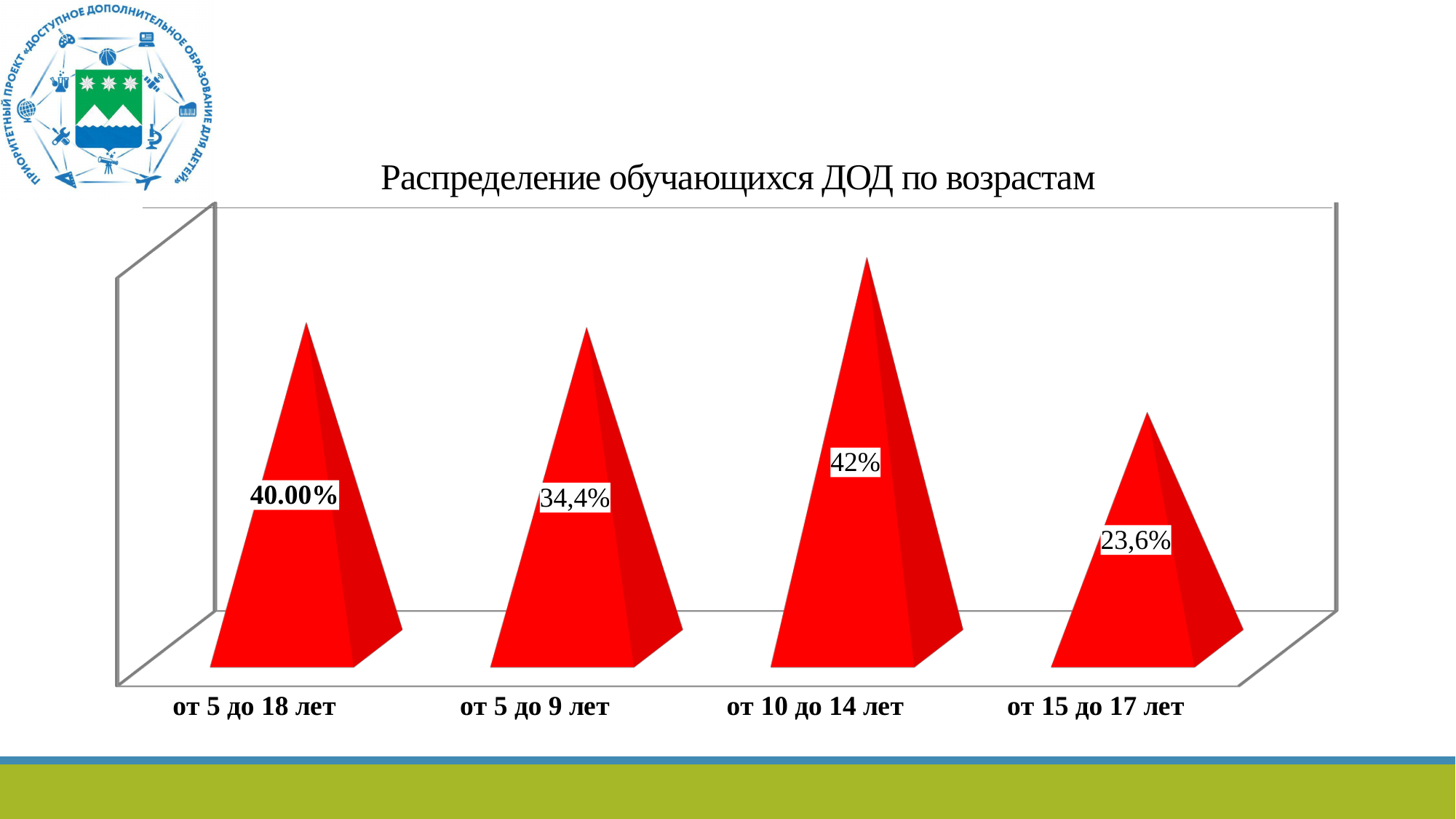
What is the value for the category "от 10 до 14 лет"? 42% What is the difference between the values for "от 10 до 14 лет" and "от 5 до 9 лет"? 7,6% What is the value for the category "от 5 до 18 лет"? 40.00% How many categories are shown on the chart? 4 Which category has the highest value? от 10 до 14 лет What kind of chart is shown on the slide? Bar chart What is the difference between the values for "от 5 до 9 лет" and "от 15 до 17 лет"? 10,8% What is the value for the category "от 5 до 9 лет"? 34,4% What is the title of the chart? Распределение обучающихся ДОД по возрастам Which category has the lowest value? от 15 до 17 лет Which is larger: the value for "от 5 до 18 лет" or the value for "от 5 до 9 лет"? от 5 до 18 лет What is the value for the category "от 15 до 17 лет"? 23,6%